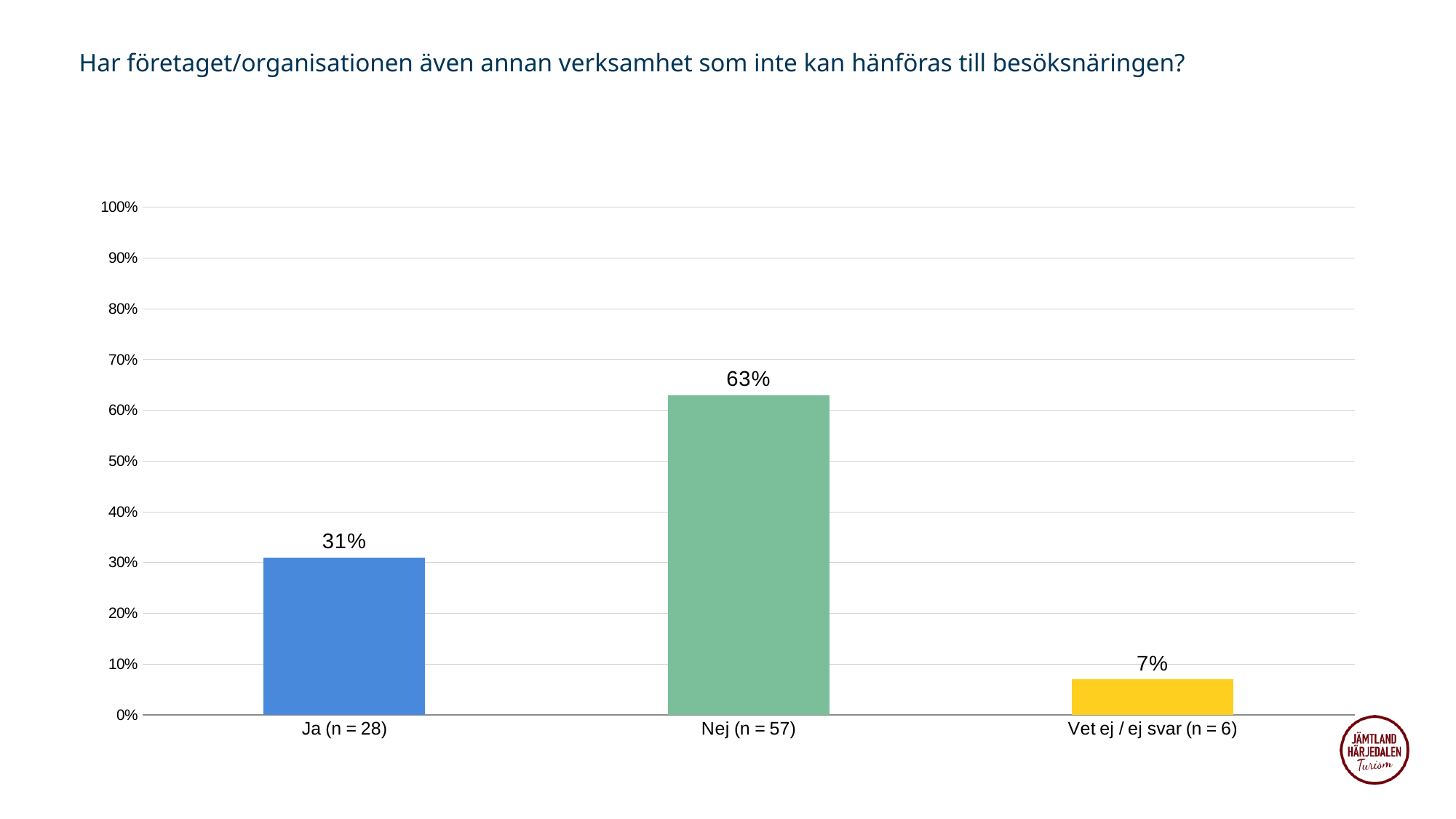
What is the difference between the values for "Nej (n = 57)" and "Ja (n = 28)"? 32% Which is larger, the value for "Ja (n = 28)" or the value for "Vet ej / ej svar (n = 6)"? Ja (n = 28) What colour is the bar for "Nej (n = 57)"? green How many categories are shown on the x axis? 3 What kind of chart is shown on the slide? bar chart Which category has the highest value? Nej (n = 57) Which category has the lowest value? Vet ej / ej svar (n = 6) What is the value for "Ja (n = 28)"? 31% Is the value for "Nej (n = 57)" greater or less than 50%? greater What is the title of the chart? Har företaget/organisationen även annan verksamhet som inte kan hänföras till besöksnäringen? What is the value for "Vet ej / ej svar (n = 6)"? 7% What is the value for "Nej (n = 57)"? 63%